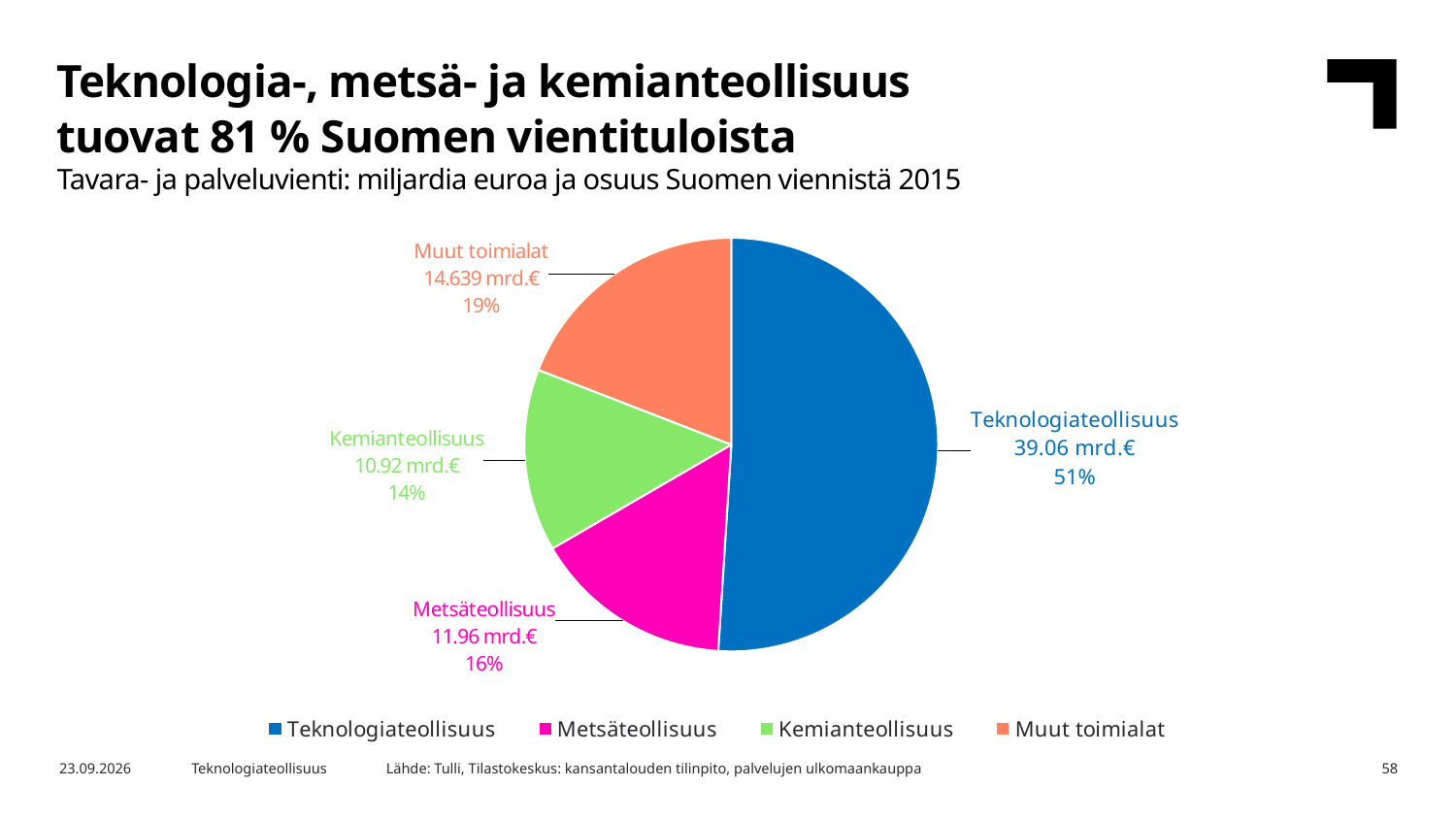
Which is larger, the export value of Metsäteollisuus or Muut toimialat? Muut toimialat Which sector has the smallest slice of the pie? Kemianteollisuus What is the export value shown for Kemianteollisuus? 10.92 mrd.€ What is the export value shown for Teknologiateollisuus? 39.06 mrd.€ What colour is the Kemianteollisuus slice? Green What share of Finland's exports does Metsäteollisuus account for? 16% What is the difference in export value between Teknologiateollisuus and Metsäteollisuus? 27.10 mrd.€ What share of the pie does Muut toimialat represent? 19% How many entries does the legend list? 4 Which sector has the largest slice of the pie? Teknologiateollisuus What kind of chart is shown on the slide? Pie chart How many slices does the pie chart have? 4